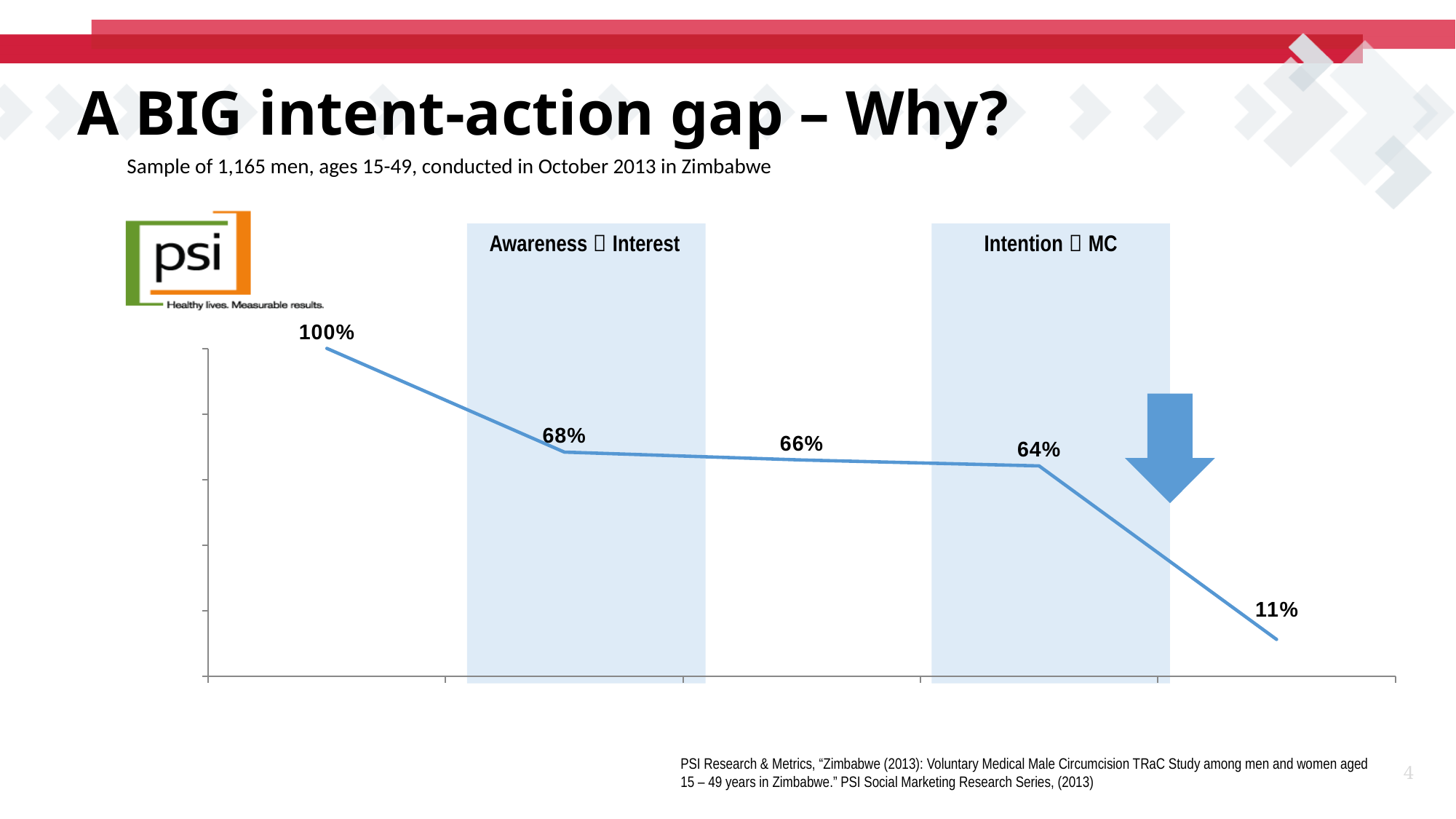
How many data points are plotted on the line? 5 What is the value of the middle (third) point on the line? 66% What label appears in the shaded band on the right side of the chart? Intention MC Which point has the highest value? the first point, 100% What is the value of the last (rightmost) point on the line? 11% What kind of chart is shown on the slide? line chart What is the value of the second point on the line? 68% Do the values rise or fall from left to right along the line? fall What is the difference between the fourth point (64%) and the last point (11%)? 53% What is the value of the first (leftmost) point on the line? 100% What is the value of the fourth point on the line? 64% Which point has the lowest value? the last point, 11%